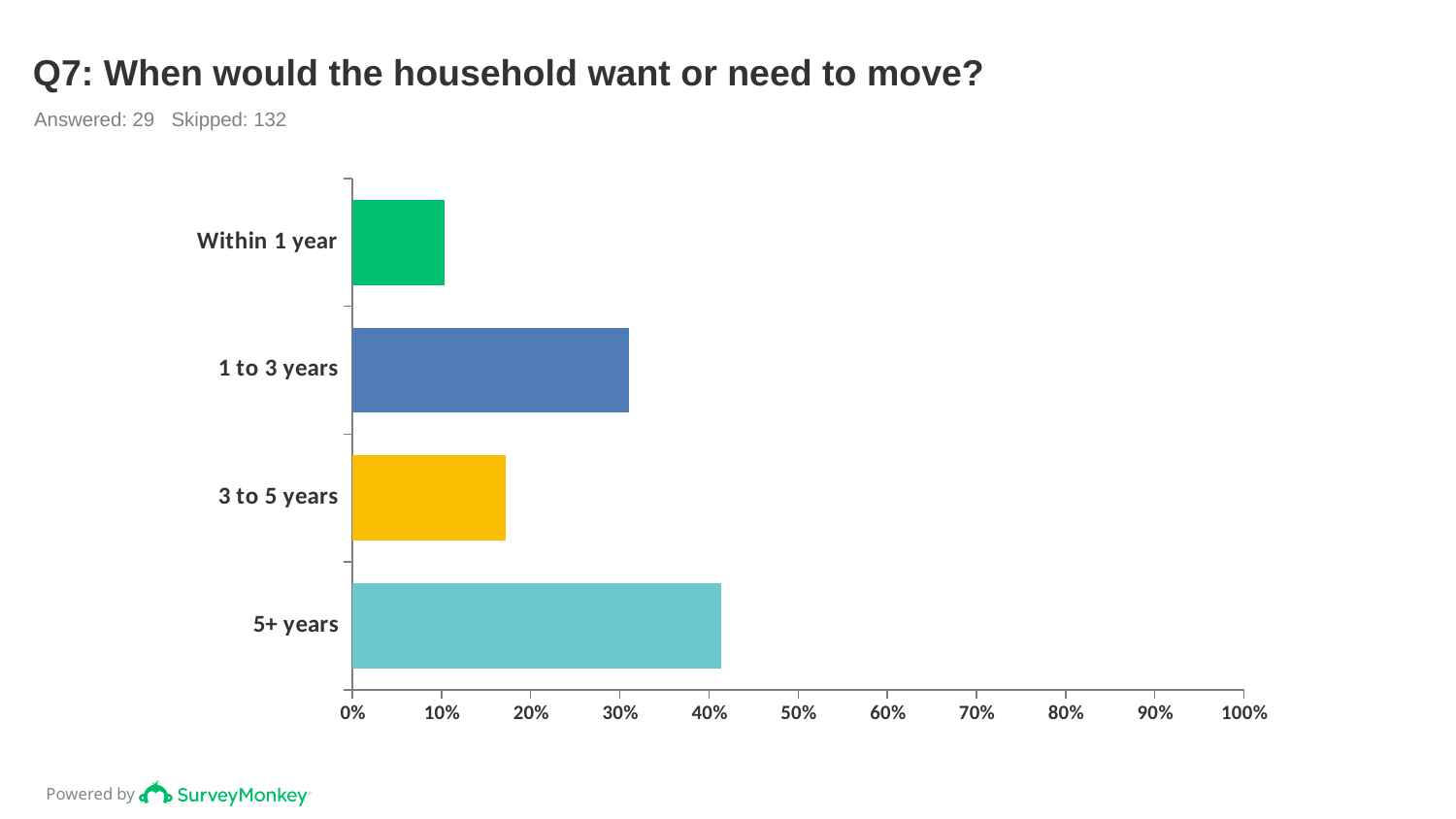
Which is larger, the value for Within 1 year or the value for 5+ years? 5+ years Is the value for 5+ years greater or less than 30%? greater Is the value for 3 to 5 years greater or less than 20%? less Is the value for 5+ years greater or less than 50%? less What kind of chart is shown on the slide? bar chart What is the title of the chart? Q7: When would the household want or need to move? Which category has the lowest value? Within 1 year Which is larger, the value for 1 to 3 years or the value for 3 to 5 years? 1 to 3 years How many categories are shown in the chart? 4 Which category has the highest value? 5+ years